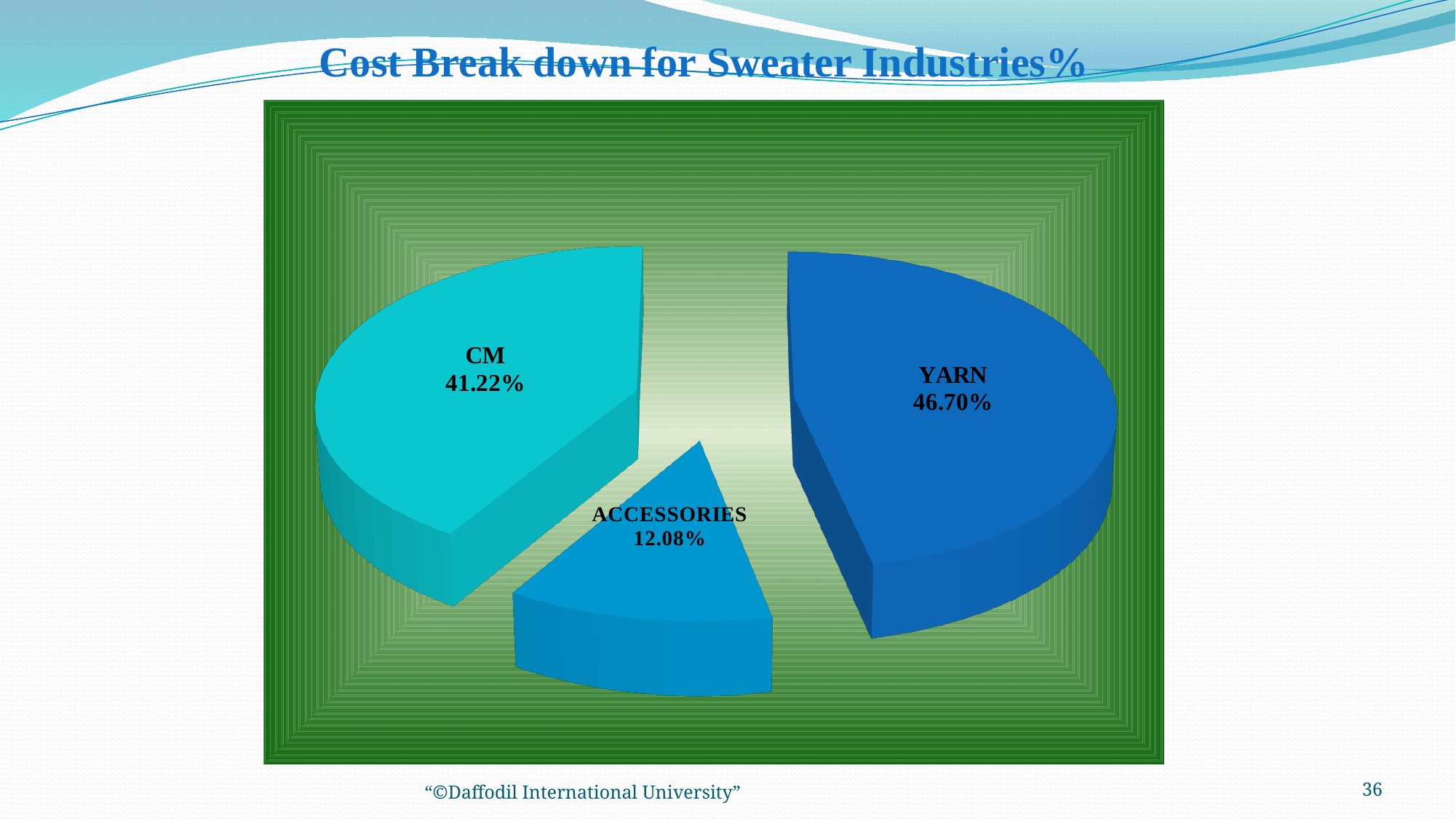
What is the title of the slide? Cost Break down for Sweater Industries% What colour is the YARN slice? Dark blue What kind of chart is shown on the slide? Pie chart What is the value for YARN? 46.70% Which category has the largest share of the pie? YARN What is the difference between the CM and ACCESSORIES values? 29.14% How many slices does the pie chart have? 3 Which is larger, the value for CM or the value for ACCESSORIES? CM What is the value for CM? 41.22% Which category has the smallest share of the pie? ACCESSORIES What is the value for ACCESSORIES? 12.08% What is the difference between the YARN and CM values? 5.48%